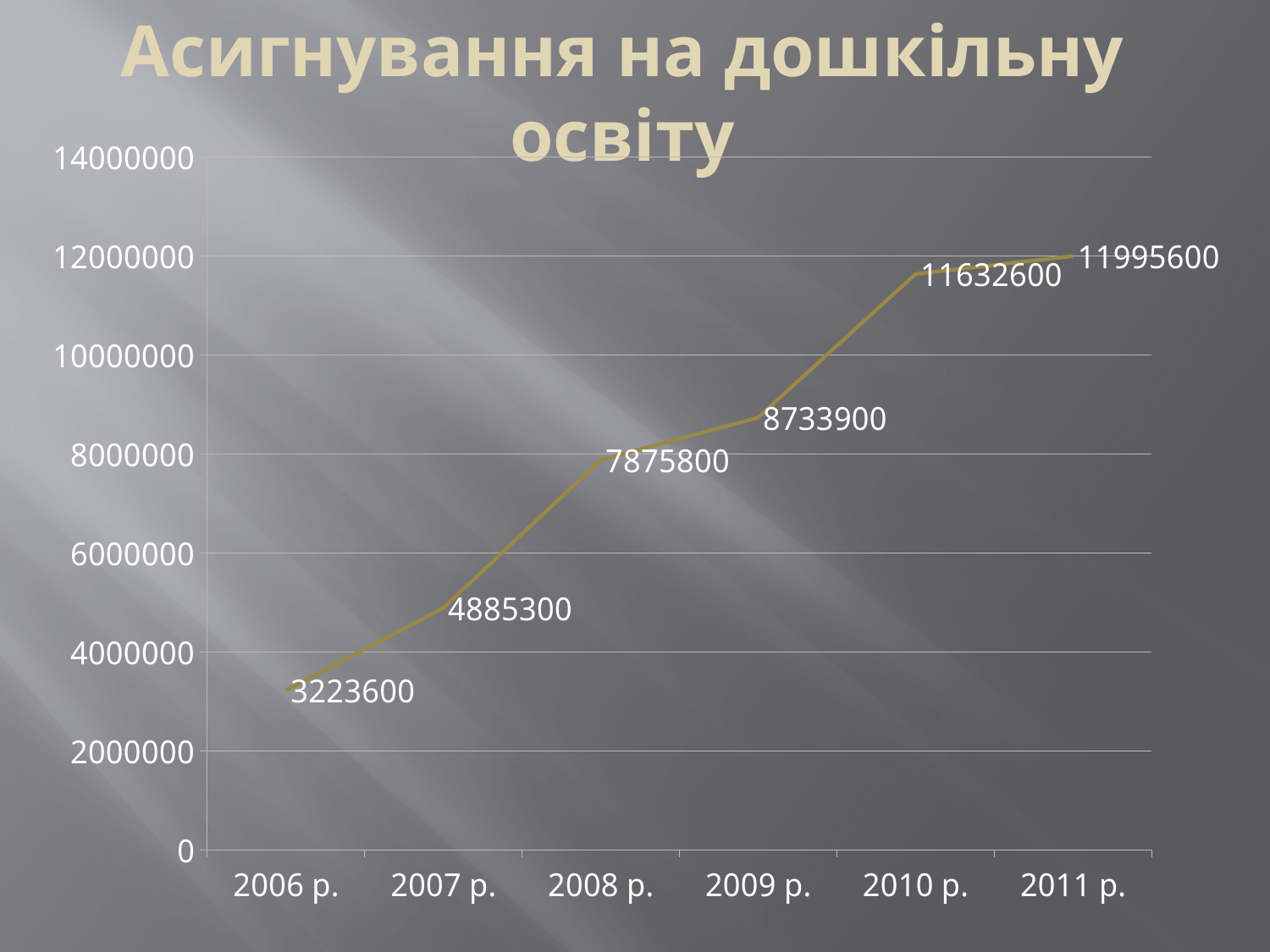
How many years are plotted on the chart? 6 Which is larger, the value for 2008 р. or the value for 2009 р.? 2009 р. What is the value for 2009 р.? 8733900 What is the difference between the values for 2008 р. and 2007 р.? 2990500 Do the values rise or fall from 2006 р. to 2011 р.? rise Is the value for 2007 р. greater or less than 6000000? less What kind of chart is shown on the slide? line chart What is the value for 2011 р.? 11995600 Which year has the highest value? 2011 р. What is the value for 2006 р.? 3223600 What is the difference between the values for 2011 р. and 2010 р.? 363000 Which year has the lowest value? 2006 р.